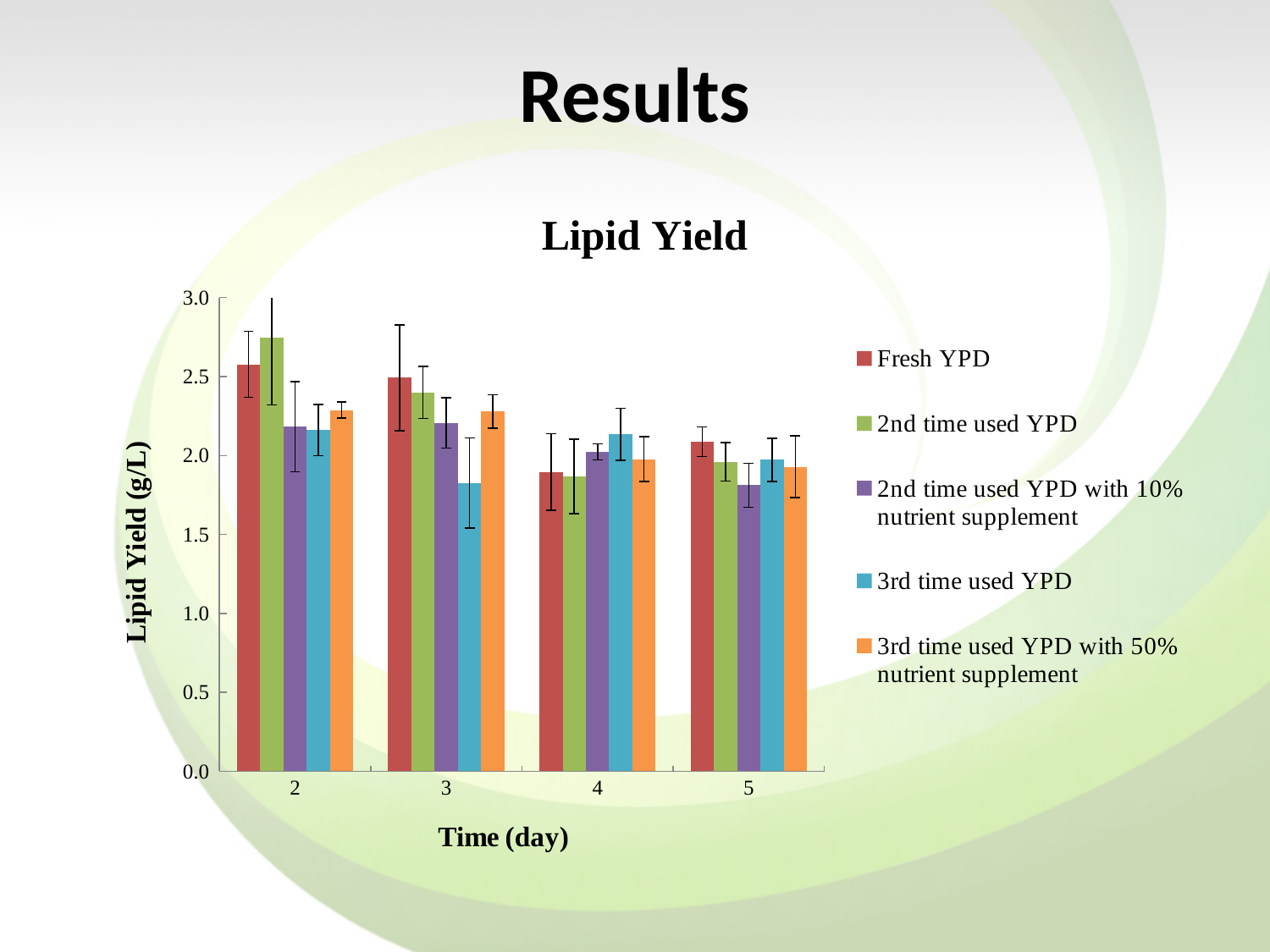
Which is larger for 3rd time used YPD: the value at day 2 or the value at day 3? day 2 Is the value for 2nd time used YPD at day 2 greater or less than 2.5? greater At day 2, which series has the highest lipid yield? 2nd time used YPD At day 3, which series has the lowest lipid yield? 3rd time used YPD What kind of chart is shown on the slide? bar chart Does the lipid yield for Fresh YPD rise or fall from day 2 to day 4? fall Is the value for 3rd time used YPD at day 3 greater or less than 2.0? less What is the title of the y axis? Lipid Yield (g/L) Which is larger for Fresh YPD: the value at day 2 or the value at day 4? day 2 Is the value for 2nd time used YPD with 10% nutrient supplement at day 5 greater or less than 2.0? less How many time points (days) are shown on the x axis? 4 How many series does the legend list? 5